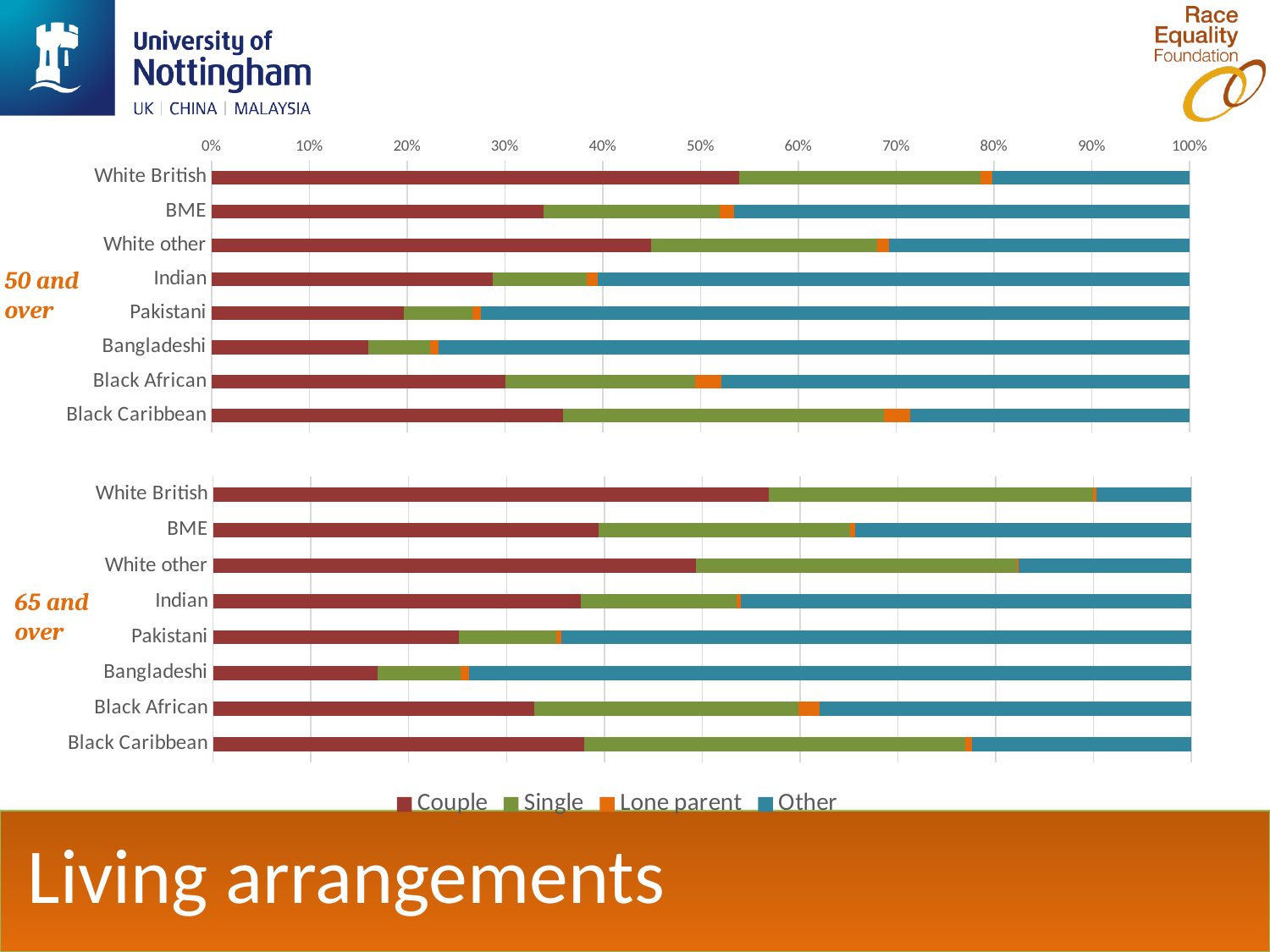
Which series is shown in orange in the legend? Lone parent How many series does the legend list? 4 In the '50 and over' chart, how many ethnic groups are shown? 8 In the '50 and over' chart, which group has the smallest Couple share? Bangladeshi In the '50 and over' chart, is the Couple share for Bangladeshi greater or less than 20%? less In the '65 and over' chart, which group has the smallest Couple share? Bangladeshi What type of chart is used on this slide? Stacked bar chart In the '50 and over' chart, is the Couple share for White British greater or less than 50%? greater In the '65 and over' chart, how many ethnic groups are shown? 8 In the '50 and over' chart, which has the larger Couple share, White other or BME? White other In the '50 and over' chart, which group has the largest Couple share? White British In the '65 and over' chart, which group has the largest Couple share? White British